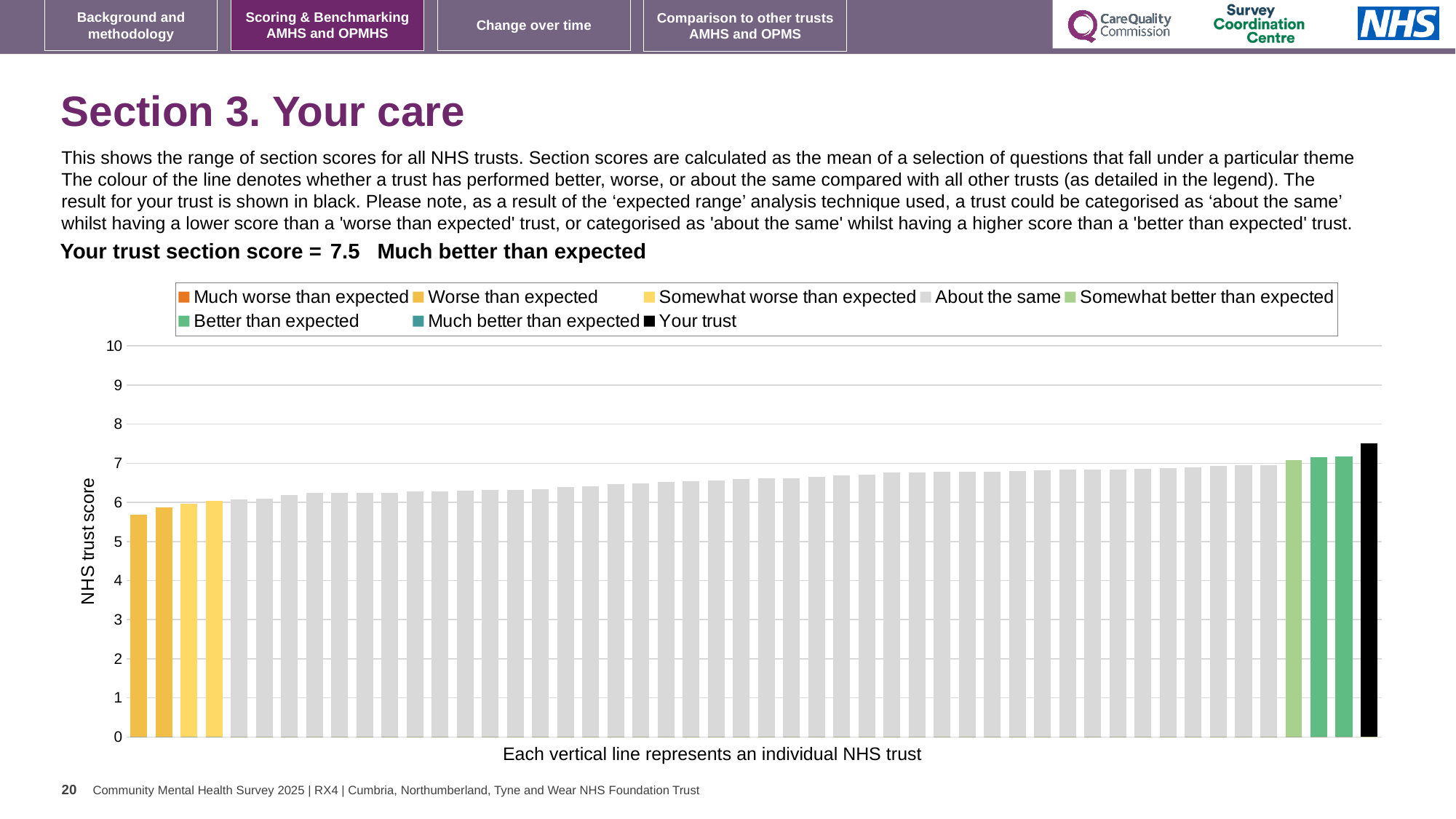
What is the label on the vertical axis of the chart? NHS trust score What kind of chart is shown on the slide? bar chart Is the value of the black 'Your trust' bar greater or less than 7? greater How many entries does the chart legend list? 8 How many bars in the chart are coloured green? 3 What is the section score for your trust shown on the slide? 7.5 Is the value of the lowest bar in the chart greater or less than 6? less What is the maximum value shown on the vertical axis of the chart? 10 Do the bar values rise or fall from left to right along the x axis? rise Which category does your trust's section score fall into, according to the slide? Much better than expected Which bar in the chart is the highest? Your trust What colour is used for the 'Your trust' bar in the chart? black